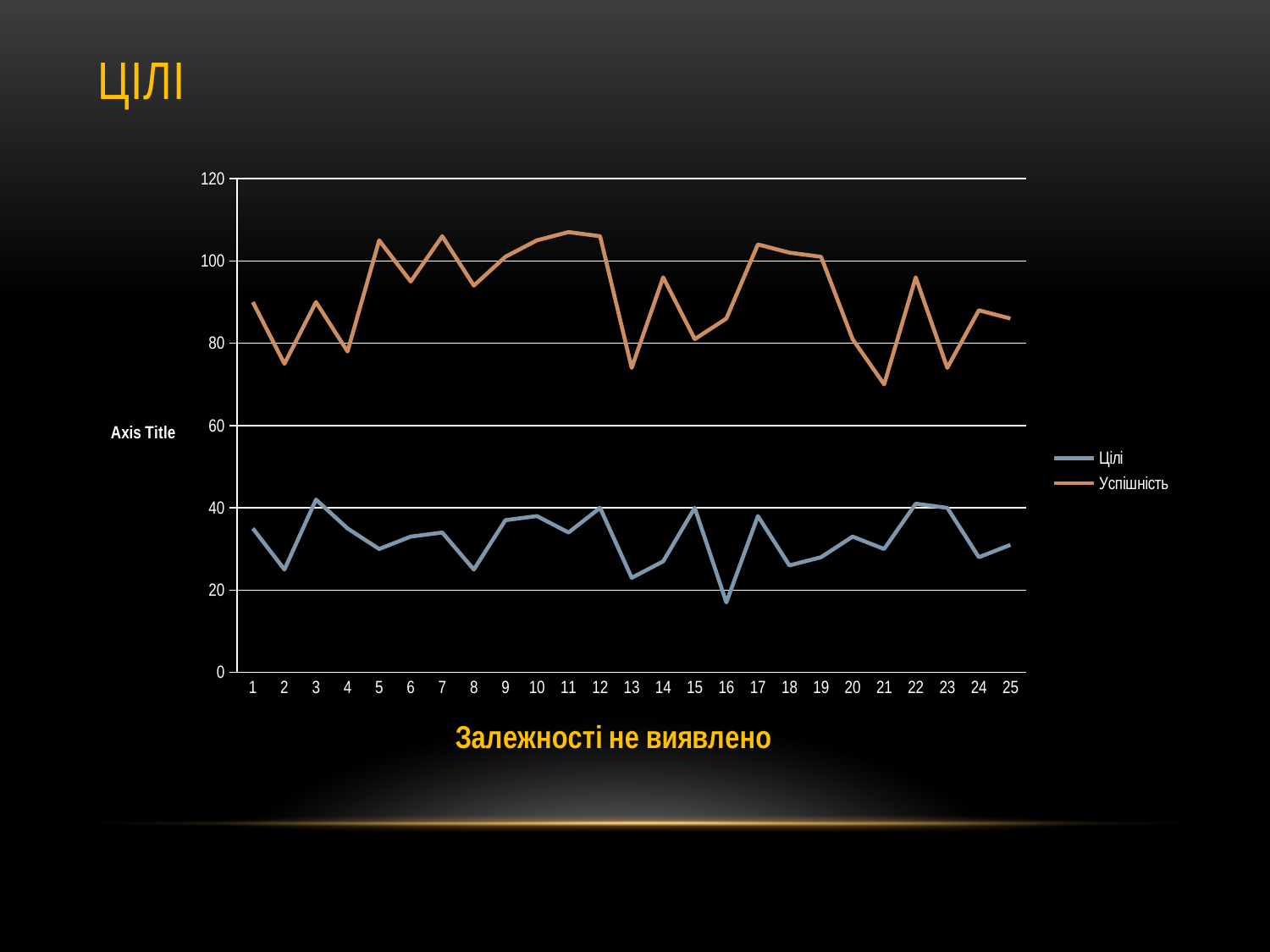
Is the value for Успішність at point 21 greater or less than 80? less Which series is plotted higher across the chart, Цілі or Успішність? Успішність At which x-axis point does the Успішність series reach its lowest value? 21 What are the two legend entries of the chart? Цілі and Успішність At which x-axis point does the Цілі series reach its lowest value? 16 Is the value for Цілі at point 13 greater or less than 40? less What kind of chart is shown on the slide? line chart How many points are plotted along the x axis for each series? 25 How many series does the legend list? 2 Is the value for Успішність at point 5 greater or less than 100? greater Which is larger, the Цілі value at point 3 or the Цілі value at point 16? point 3